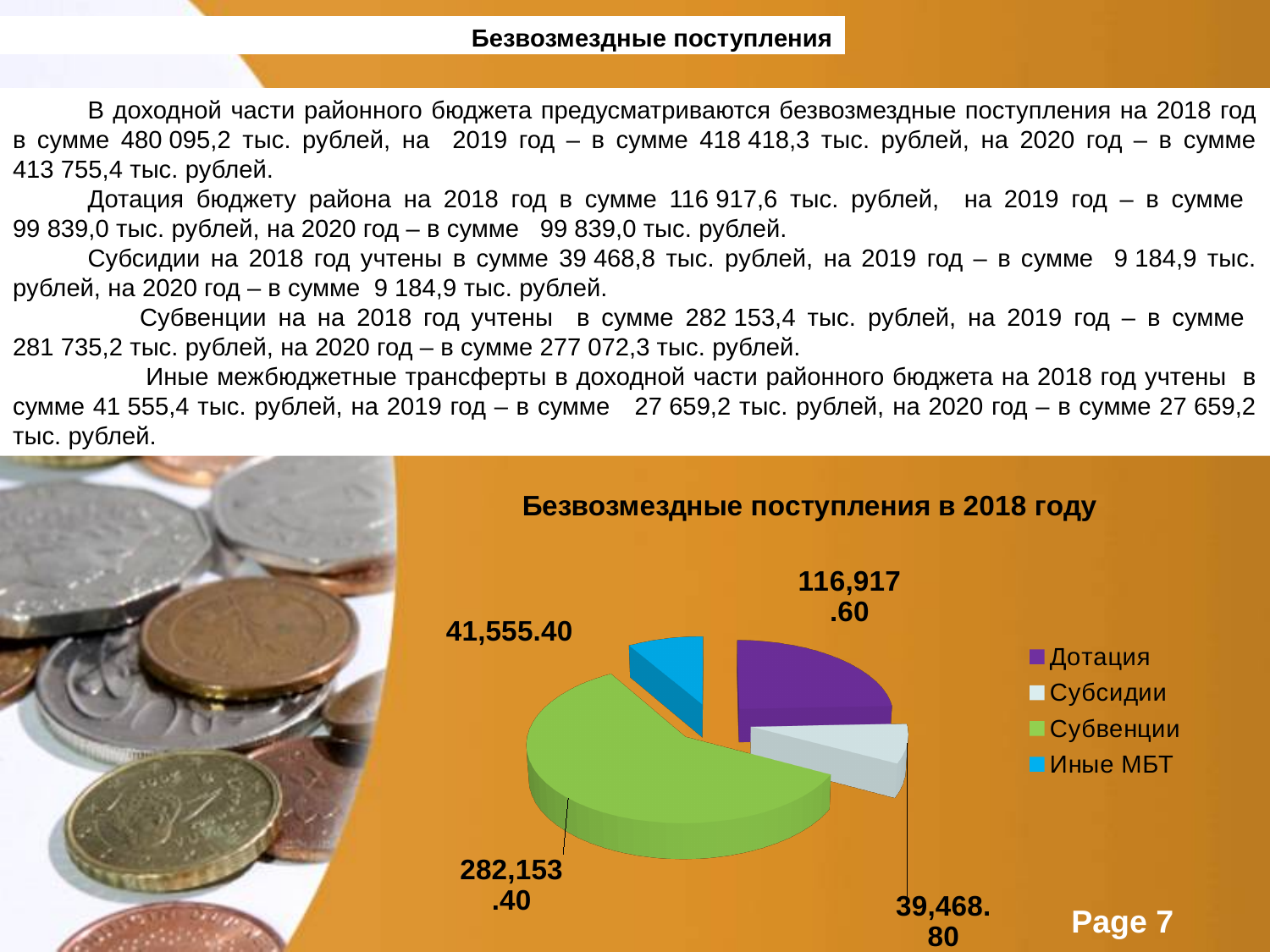
What is the value shown for Дотация in the pie chart? 116,917.60 Which is larger in the pie chart, Иные МБТ or Субсидии? Иные МБТ How many slices does the pie chart have? 4 What type of chart is shown on the slide? Pie chart What is the value shown for Субсидии in the pie chart? 39,468.80 What is the title of the chart? Безвозмездные поступления в 2018 году What is the value shown for Иные МБТ in the pie chart? 41,555.40 Which category has the smallest slice in the pie chart? Субсидии How many entries does the chart legend list? 4 What is the difference between the values for Субвенции and Дотация in the pie chart? 165,235.80 What is the value shown for Субвенции in the pie chart? 282,153.40 Which category has the largest slice in the pie chart? Субвенции